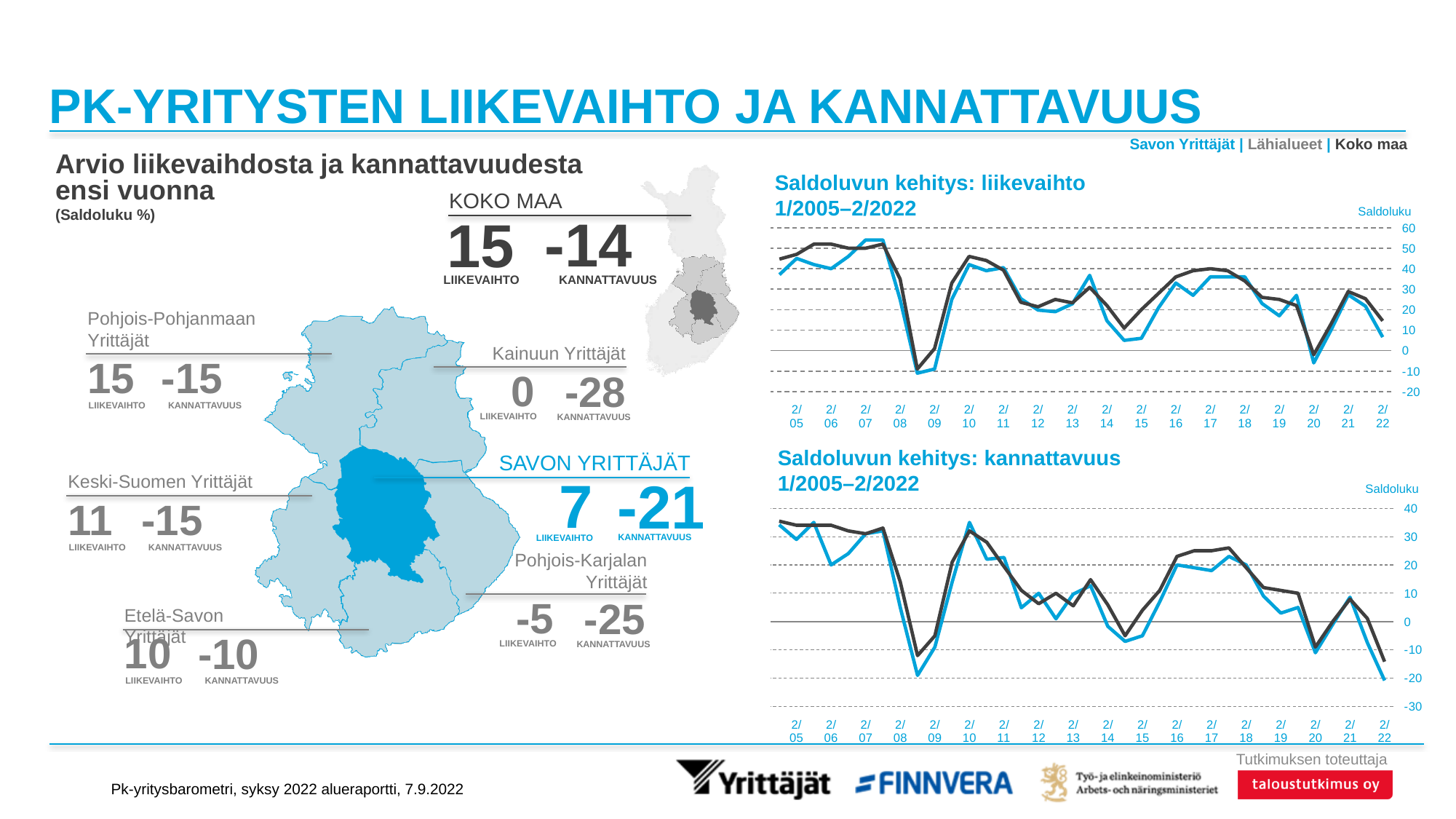
What kind of chart is 'Saldoluvun kehitys: liikevaihto 1/2005–2/2022'? Line chart In the 'Saldoluvun kehitys: liikevaihto' chart, is the Savon Yrittäjät value at 2/09 greater or less than 0? less In the 'Saldoluvun kehitys: kannattavuus' chart, do the values rise or fall from 2/18 to 2/22? fall In the 'Saldoluvun kehitys: kannattavuus' chart, is the Savon Yrittäjät value at 2/10 greater or less than 20? greater In the 'Saldoluvun kehitys: liikevaihto' chart, do the values rise or fall from 2/08 to 2/09? fall In the 'Saldoluvun kehitys: kannattavuus' chart, is the Savon Yrittäjät value at 2/22 greater or less than -10? less How many series does the legend at the top right of the slide list? 3 In the map infographic, what is the kannattavuus value for Savon Yrittäjät? -21 What is the highest value shown on the y axis of the 'Saldoluvun kehitys: kannattavuus' chart? 40 In the 'Saldoluvun kehitys: liikevaihto' chart, how many time points are labelled on the x axis? 18